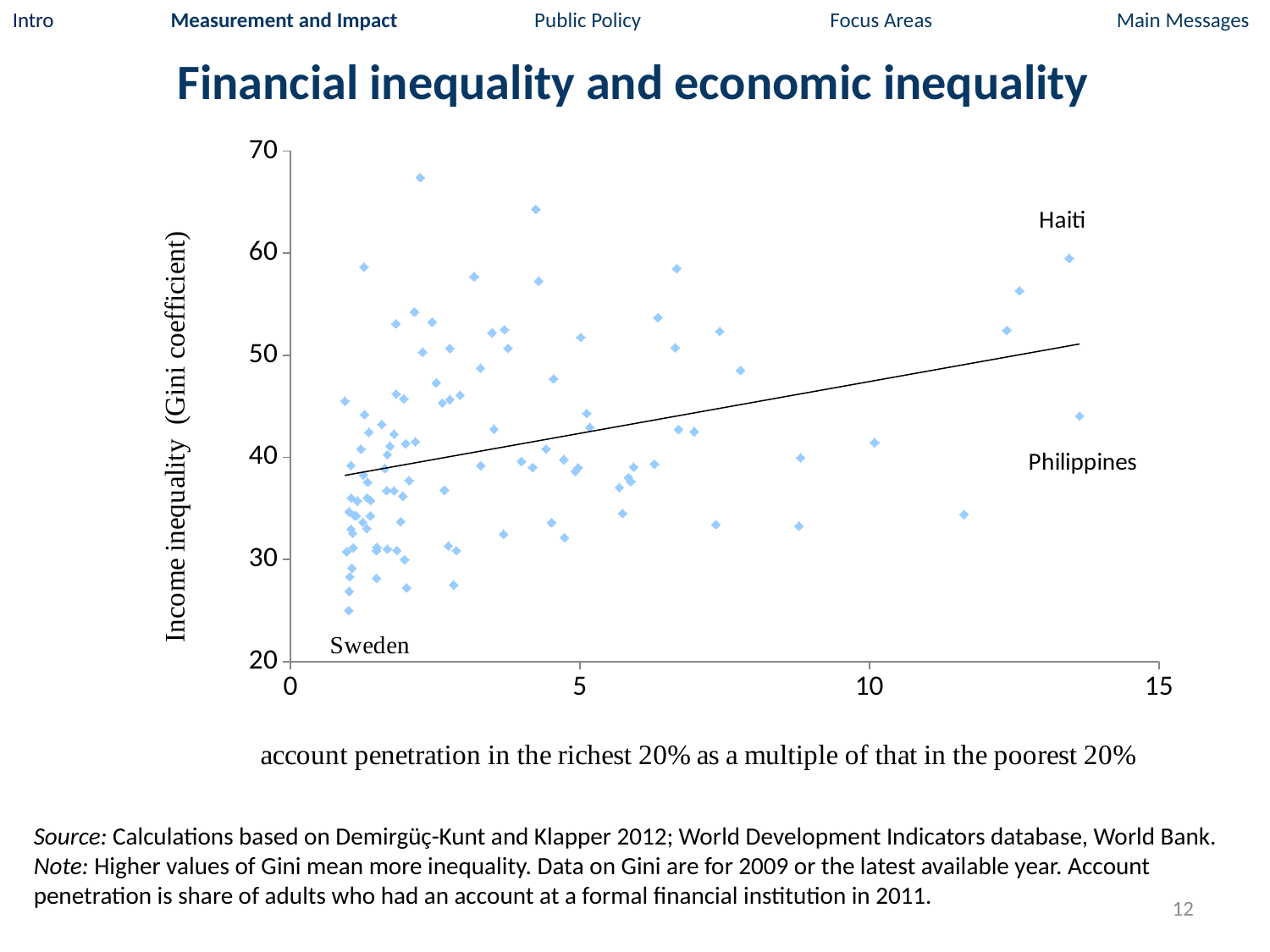
Which has a higher Gini coefficient, Sweden or Haiti? Haiti What is the label of the vertical axis? Income inequality (Gini coefficient) Is the account penetration ratio (x value) for Haiti greater or less than 10? greater Is the Gini coefficient for Haiti greater or less than 50? greater What kind of chart is shown on the slide? Scatter chart Is the Gini coefficient for the Philippines greater or less than 50? less What is the title of the chart? Financial inequality and economic inequality Does the fitted trend line rise or fall as account penetration ratio increases along the x axis? Rises What is the maximum value shown on the horizontal axis? 15 Which has a higher Gini coefficient, Haiti or the Philippines? Haiti